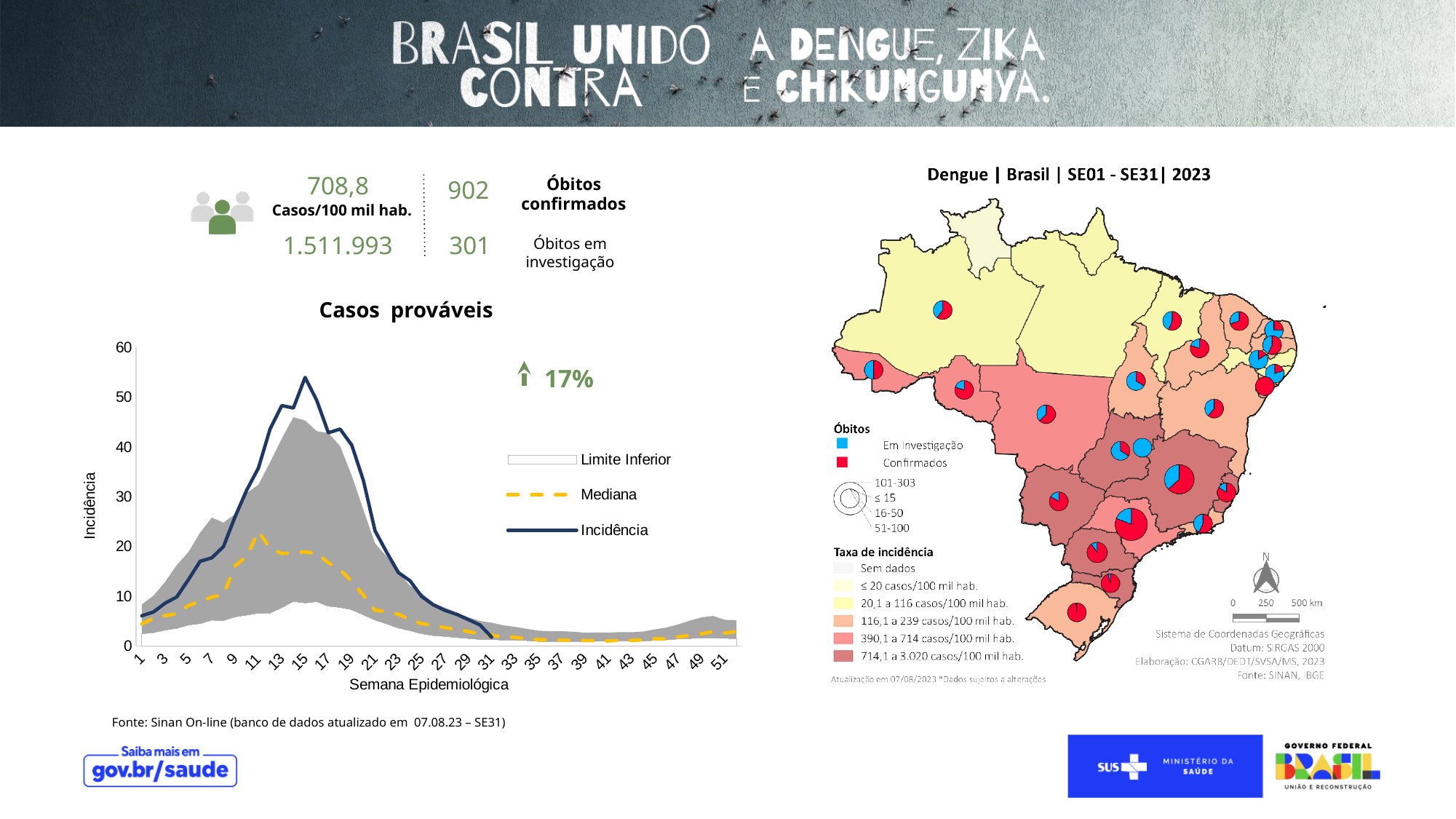
In the 'Casos prováveis' chart, is the Incidência value at week 31 greater or less than 10? less How many series does the legend of the 'Casos prováveis' chart list? 3 In the 'Casos prováveis' chart, is the Incidência value at week 1 greater or less than 10? less In the 'Casos prováveis' chart, does the Incidência line rise or fall between week 15 and week 31? fall In the 'Casos prováveis' chart, at week 15, which is larger: the Incidência value or the Mediana value? Incidência What kind of chart is the 'Casos prováveis' chart? combination area and line chart In the 'Casos prováveis' chart, does the Incidência line rise or fall between week 1 and week 15? rise Which legend entry of the 'Casos prováveis' chart is drawn as a dashed line? Mediana What is the title of the x axis of the 'Casos prováveis' chart? Semana Epidemiológica In the 'Casos prováveis' chart, is the Mediana value at week 11 greater or less than 10? greater In the 'Casos prováveis' chart, at which epidemiological week does the Incidência line reach its highest value? 15